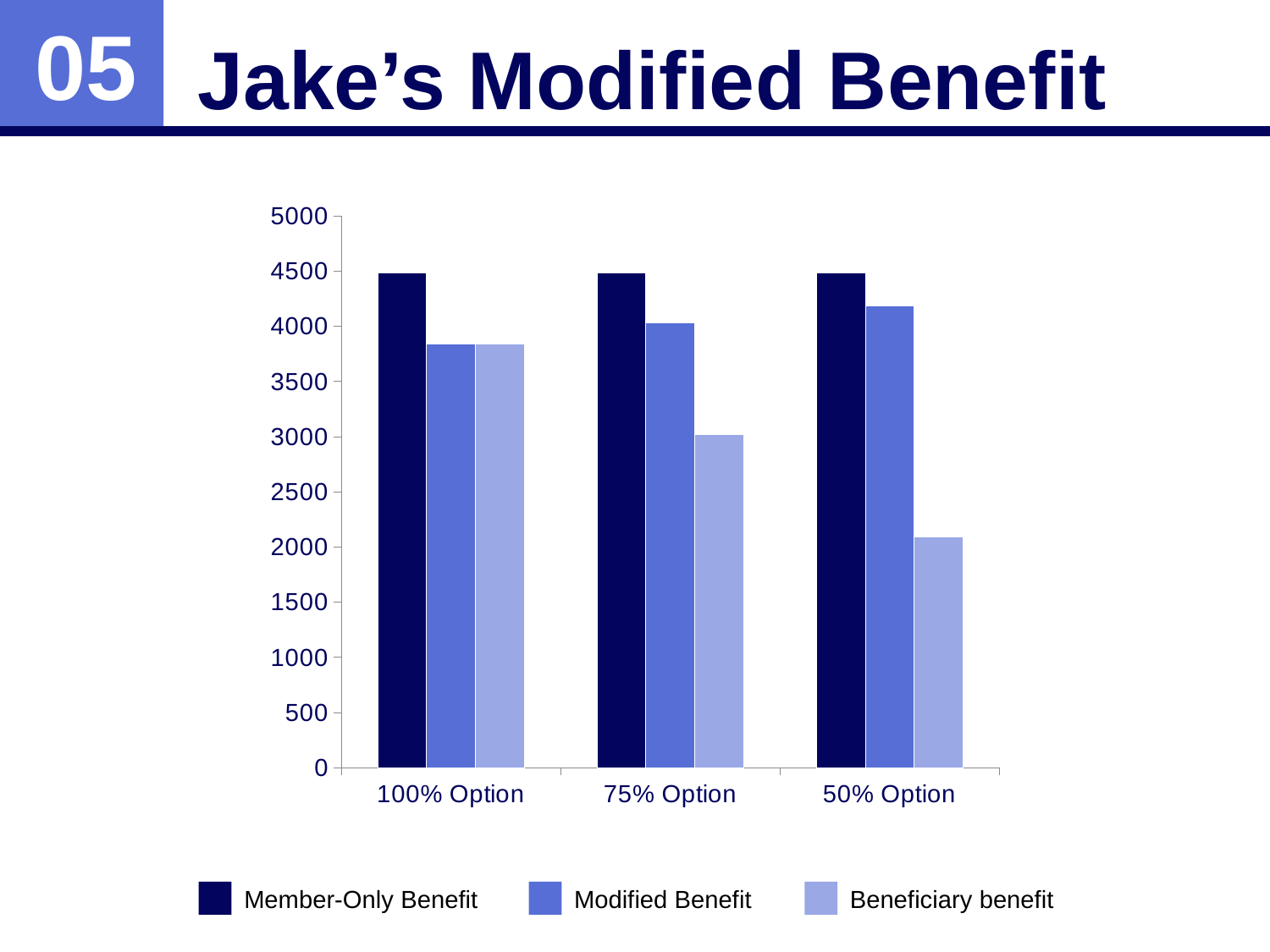
Is the Modified Benefit value for the 50% Option greater or less than 4000? greater Is the Beneficiary benefit value for the 75% Option greater or less than 3500? less Which is larger: the Beneficiary benefit for the 100% Option or for the 50% Option? 100% Option For the 75% Option, which is larger: the Modified Benefit or the Beneficiary benefit? Modified Benefit How many categories are shown on the x axis? 3 What is the title of the chart slide? Jake's Modified Benefit How many series does the legend list? 3 Is the Beneficiary benefit value for the 50% Option greater or less than 2500? less Does the Beneficiary benefit rise or fall from the 100% Option to the 50% Option? fall What kind of chart is shown on the slide? bar chart For which option is the Beneficiary benefit lowest? 50% Option